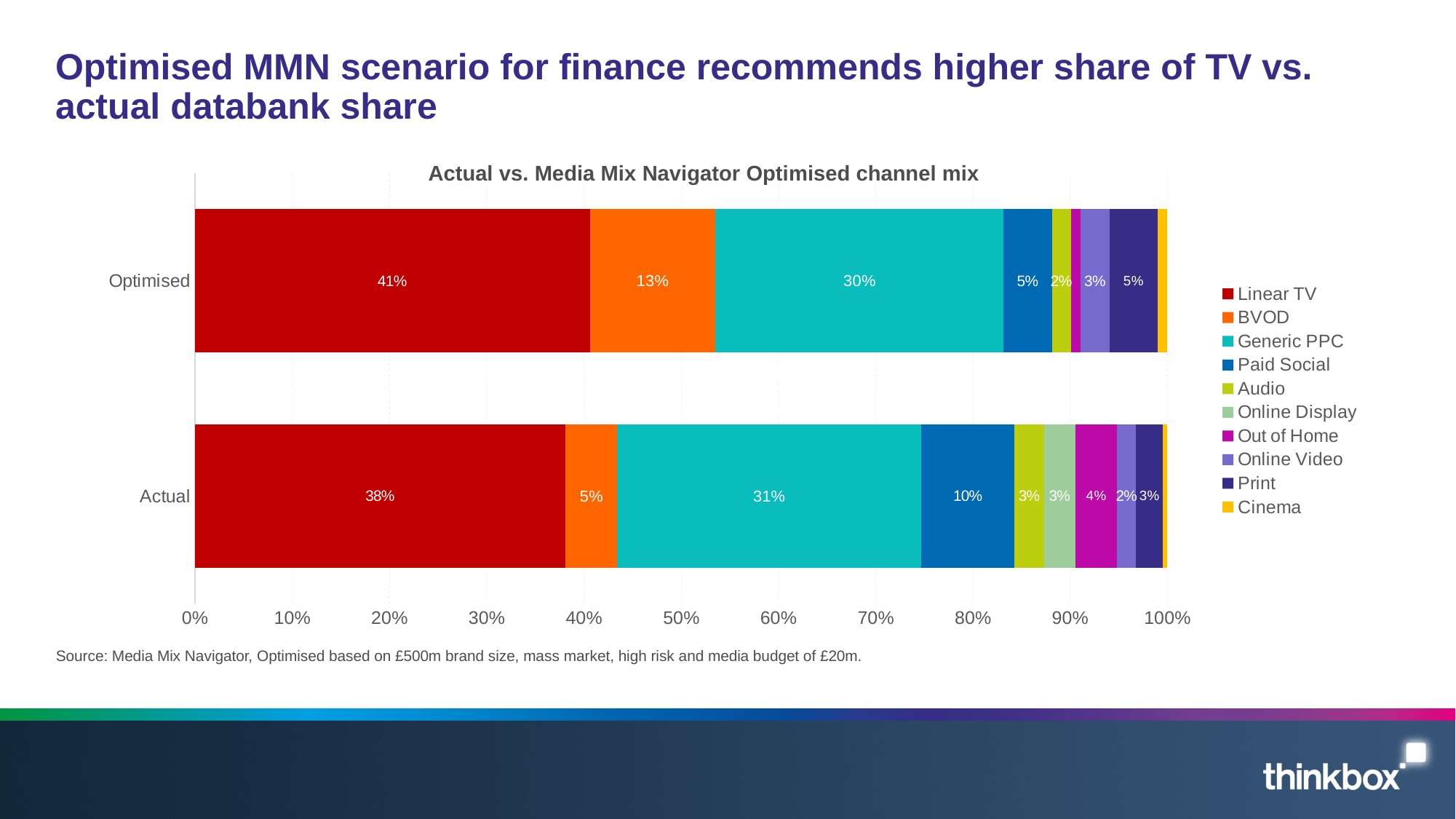
How many series does the legend list? 10 What is the Paid Social share in the Actual bar? 10% What is the BVOD share in the Optimised bar? 13% What is the title of the chart? Actual vs. Media Mix Navigator Optimised channel mix Which bar has the larger BVOD share, Optimised or Actual? Optimised What is the Linear TV share in the Optimised bar? 41% Which channel has the largest share in the Optimised bar? Linear TV By how many percentage points does the Linear TV share in the Optimised bar exceed the Linear TV share in the Actual bar? 3 percentage points How many bars are plotted in the chart? 2 What is the Linear TV share in the Actual bar? 38% What type of chart is shown on the slide? Stacked bar chart What is the Generic PPC share in the Actual bar? 31%